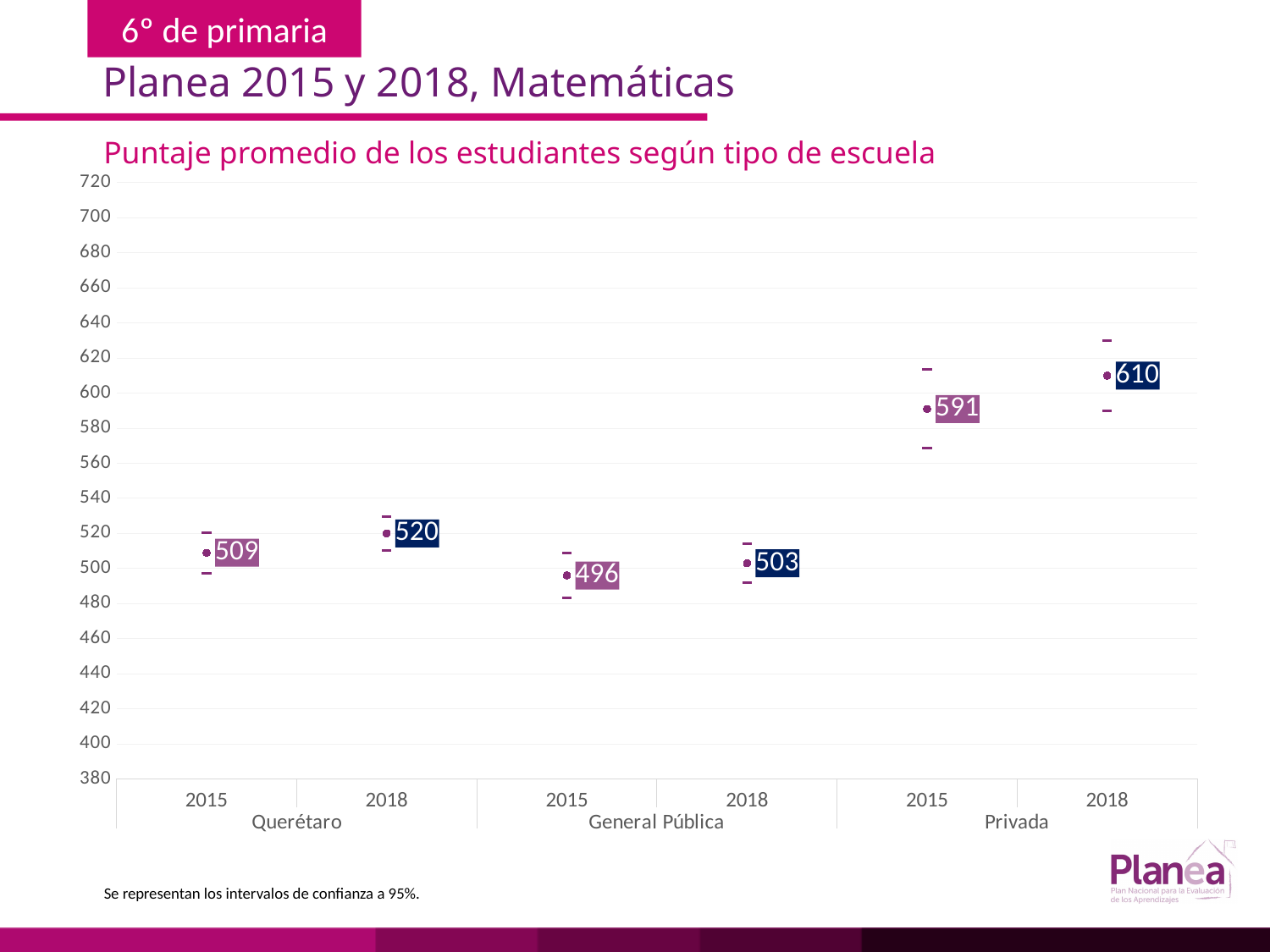
What is the average score for Privada in 2018? 610 What is the difference between the Querétaro 2018 score and the General Pública 2018 score? 17 What is the average score for Querétaro in 2018? 520 Which school type and year has the highest average score? Privada 2018 What is the average score for Querétaro in 2015? 509 What is the title of the chart? Puntaje promedio de los estudiantes según tipo de escuela What is the average score for General Pública in 2015? 496 Which school type and year has the lowest average score? General Pública 2015 Which is larger, the Querétaro 2015 score or the General Pública 2018 score? Querétaro 2015 How many data points are plotted on the chart? 6 By how many points did the Privada average score change from 2015 to 2018? 19 Did the average score for General Pública rise or fall from 2015 to 2018? rise